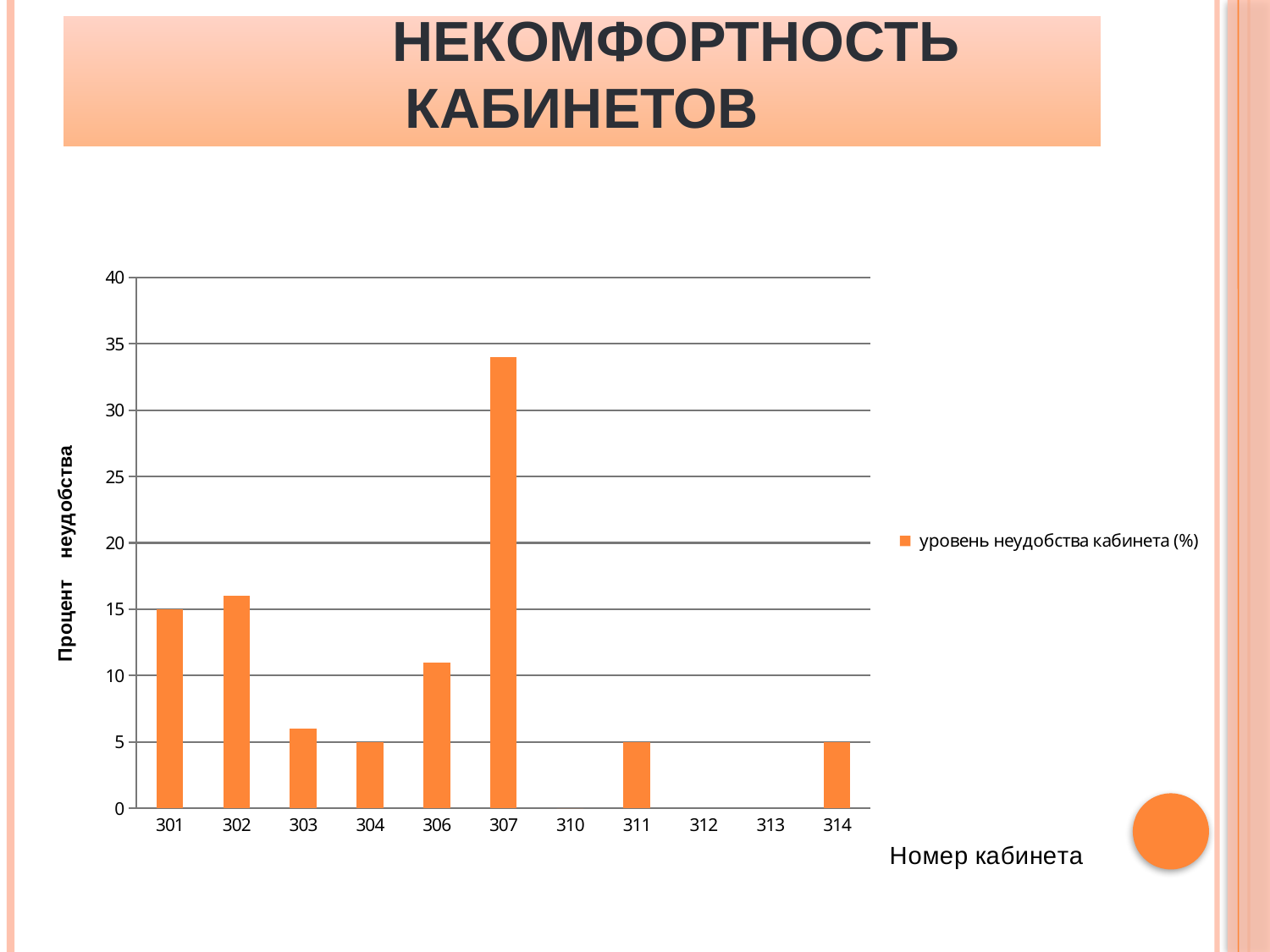
What is the legend entry for the series shown? уровень неудобства кабинета (%) What kind of chart is shown on the slide? bar chart What is the value for cabinet 314? 5 What is the value for cabinet 311? 5 Is the value for cabinet 303 greater or less than 10? less Which cabinet number has the highest discomfort level? 307 How many cabinet numbers are shown on the x axis? 11 How many series does the legend list? 1 Which has a larger value, cabinet 306 or cabinet 303? 306 Is the value for cabinet 307 greater or less than 30? greater What is the value for cabinet 304? 5 Is the value for cabinet 306 greater or less than 10? greater